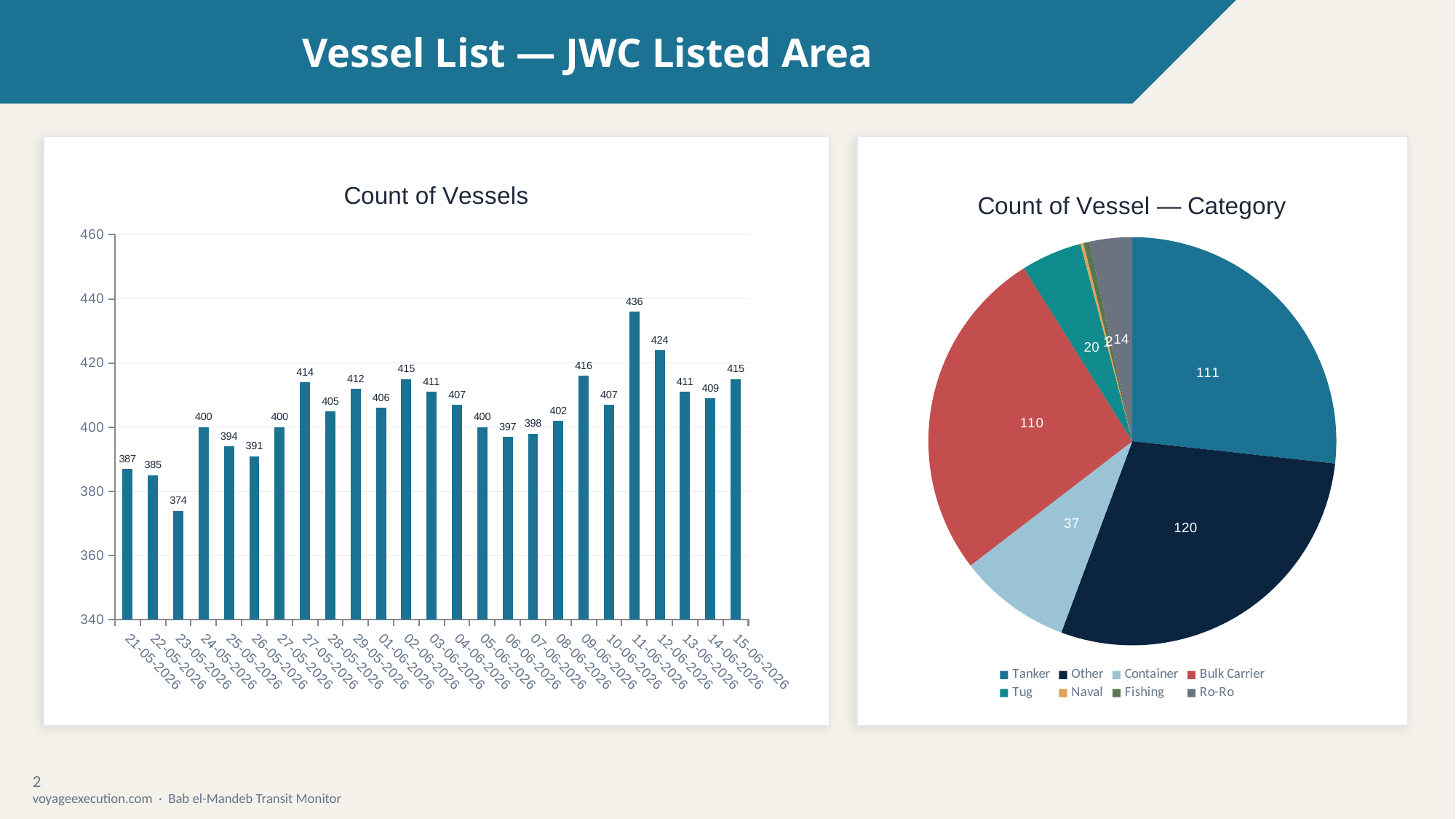
In the 'Count of Vessels' bar chart, which date has the highest count? 11-06-2026 How many categories does the legend of the 'Count of Vessel — Category' pie chart list? 8 In the 'Count of Vessels' bar chart, what is the count for 09-06-2026? 416 In the 'Count of Vessel — Category' pie chart, which category has the largest slice? Other What kind of chart is the 'Count of Vessels' chart on the left? bar chart In the 'Count of Vessels' bar chart, which date has the larger count, 24-05-2026 or 25-05-2026? 24-05-2026 How many bars are plotted in the 'Count of Vessels' chart? 25 In the 'Count of Vessel — Category' pie chart, what is the value for Container? 37 In the 'Count of Vessels' bar chart, which date has the lowest count? 23-05-2026 In the 'Count of Vessels' bar chart, what is the count for 12-06-2026? 424 In the 'Count of Vessels' bar chart, is the value for 23-05-2026 greater or less than 380? less In the 'Count of Vessels' bar chart, what is the difference between the counts for 11-06-2026 and 12-06-2026? 12